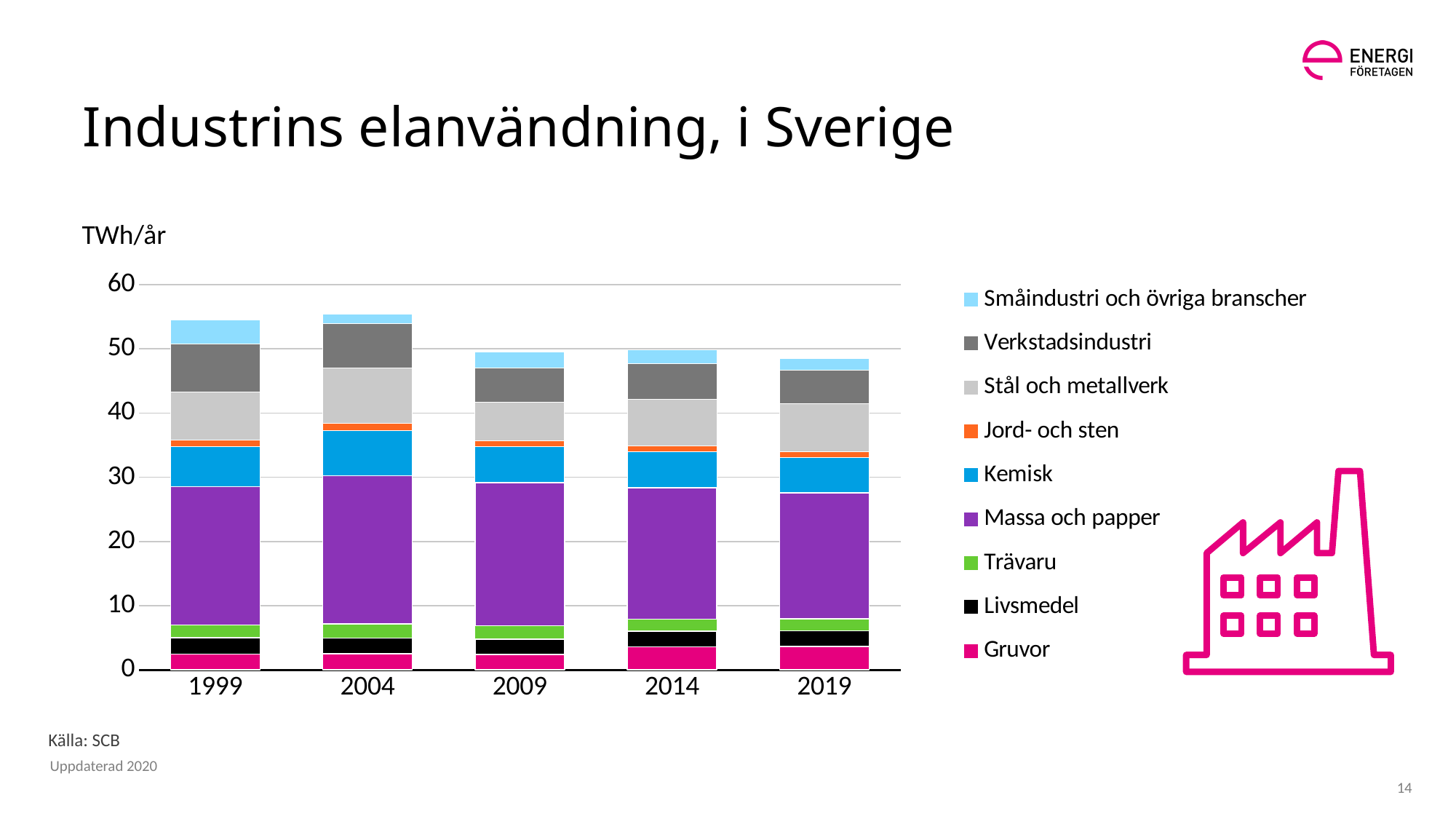
What kind of chart is shown on the slide? stacked bar chart Is the total height of the bar for 2004 greater or less than 50? greater What unit is shown above the y axis of the chart? TWh/år Which is larger, the Massa och papper segment in 2004 or in 2019? 2004 Which series forms the largest segment of the bar for 1999? Massa och papper Is the total height of the bar for 2019 greater or less than 50? less Which is larger, the Gruvor segment in 1999 or in 2014? 2014 Is the total height of the bar for 1999 greater or less than 50? greater How many years are shown on the x axis of the chart? 5 How many series does the chart's legend list? 9 Which series forms the largest segment of the bar for 2019? Massa och papper Do the total bar heights generally rise or fall from 1999 to 2019? fall